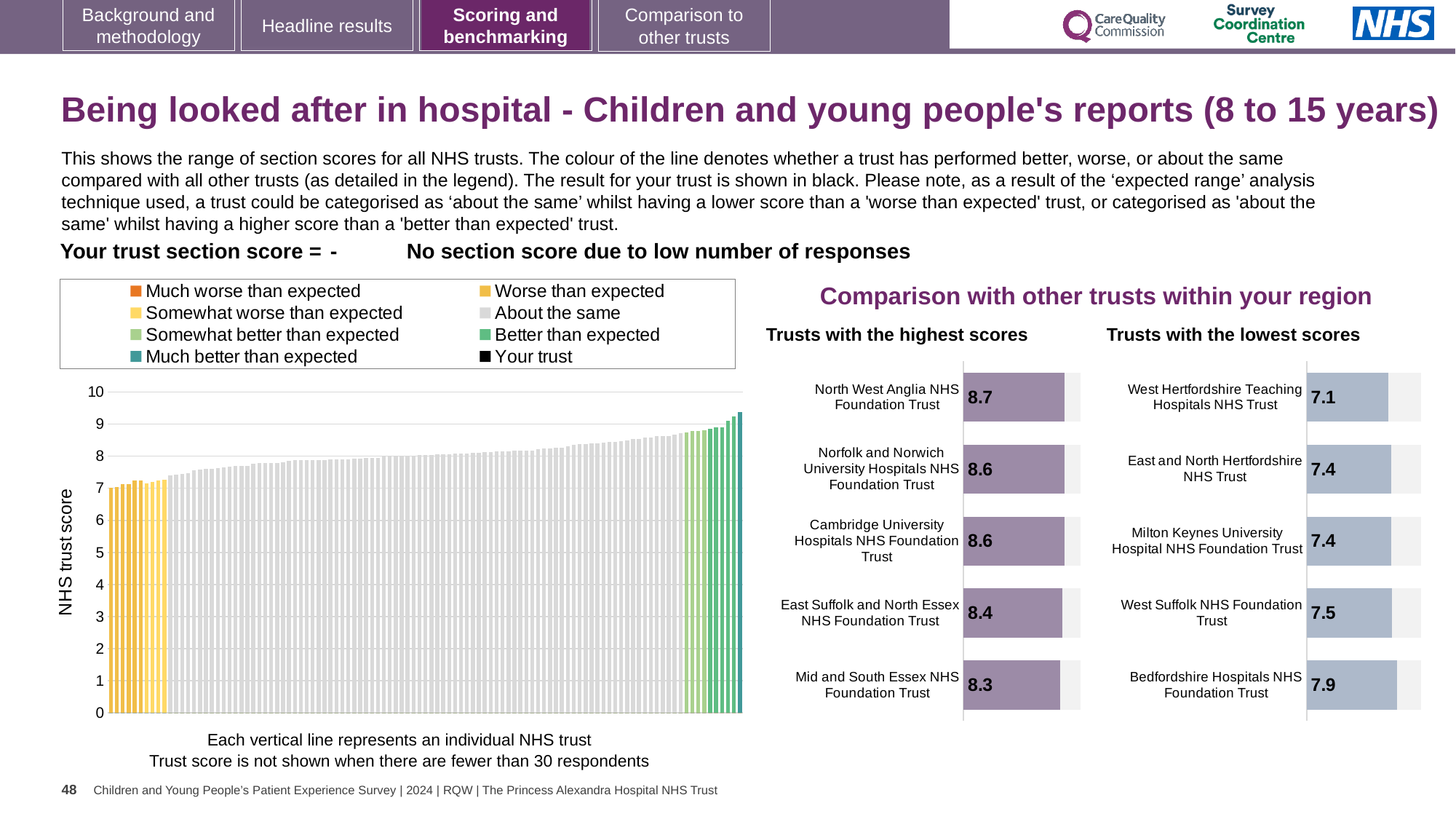
In the 'Trusts with the lowest scores' chart, what is the difference between the scores of Bedfordshire Hospitals NHS Foundation Trust and West Hertfordshire Teaching Hospitals NHS Trust? 0.8 In the large chart on the left showing all NHS trusts, is the value of the leftmost bar greater or less than 6? greater In the 'Trusts with the highest scores' chart, what is the difference between the scores of North West Anglia NHS Foundation Trust and Mid and South Essex NHS Foundation Trust? 0.4 In the large chart on the left showing all NHS trusts, do the trust scores rise or fall from left to right? rise How many entries does the legend of the large chart on the left list? 8 In the 'Trusts with the lowest scores' chart, which trust has the highest score shown? Bedfordshire Hospitals NHS Foundation Trust Which has the higher score: West Suffolk NHS Foundation Trust in the 'Trusts with the lowest scores' chart or East Suffolk and North Essex NHS Foundation Trust in the 'Trusts with the highest scores' chart? East Suffolk and North Essex NHS Foundation Trust In the 'Trusts with the lowest scores' chart, what is the score for West Hertfordshire Teaching Hospitals NHS Trust? 7.1 In the 'Trusts with the lowest scores' chart, what is the score for Milton Keynes University Hospital NHS Foundation Trust? 7.4 How many trusts are listed in the 'Trusts with the highest scores' chart? 5 In the 'Trusts with the highest scores' chart, which trust has the lowest score shown? Mid and South Essex NHS Foundation Trust In the 'Trusts with the highest scores' chart, what is the score for North West Anglia NHS Foundation Trust? 8.7